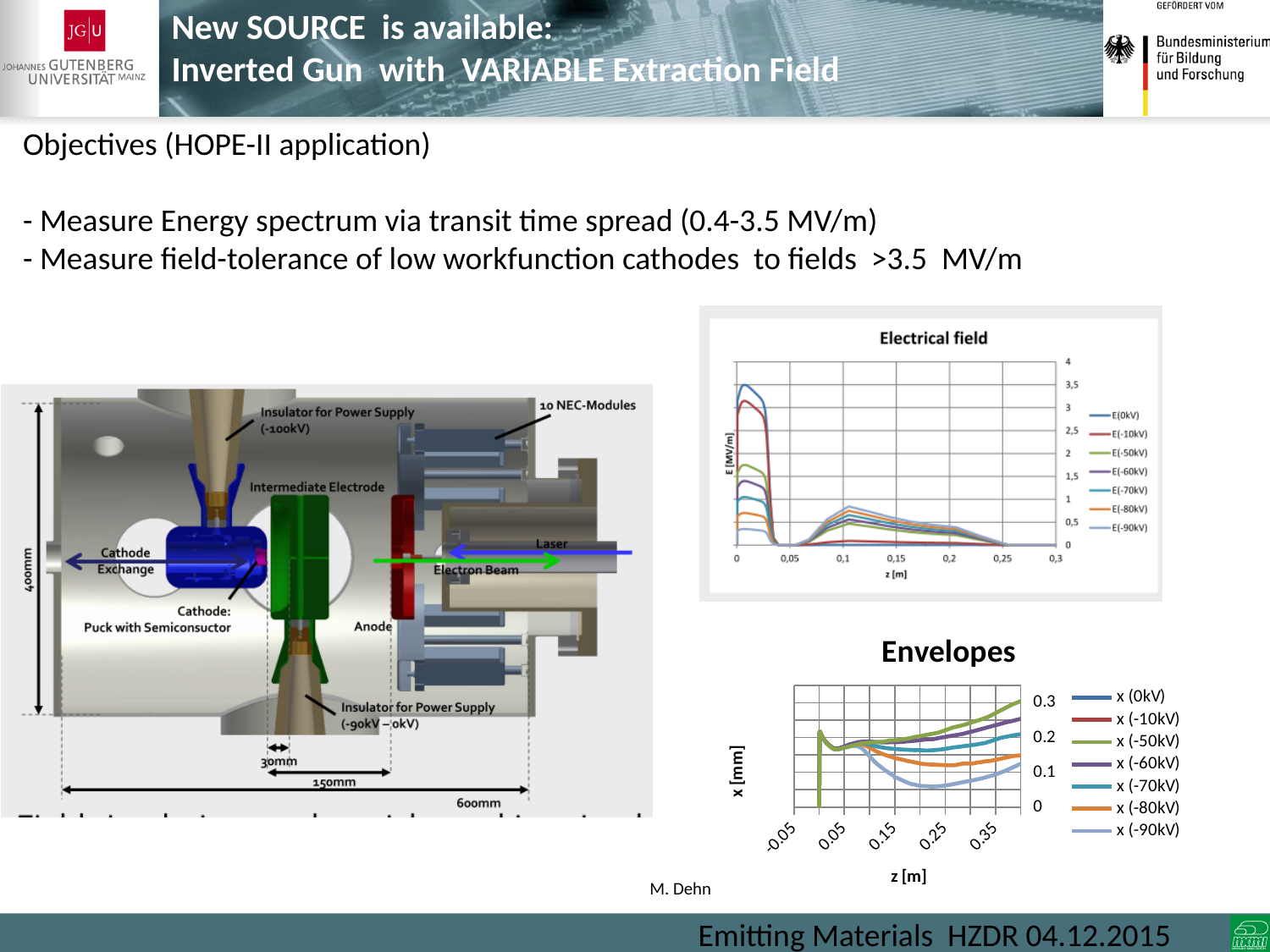
What kind of chart is the 'Electrical field' chart? line chart How many series does the legend of the 'Envelopes' chart list? 7 In the 'Electrical field' chart, which series has the lowest peak value? E(-90kV) In the 'Electrical field' chart, is the peak value of E(-90kV) greater or less than 1? less In the 'Electrical field' chart, is the peak value of E(0kV) greater or less than 3? greater What is the y-axis label of the 'Electrical field' chart? E [MV/m] In the 'Envelopes' chart, is the minimum value of x (-90kV) greater or less than 0.1? less How many series does the legend of the 'Electrical field' chart list? 7 What kind of chart is the 'Envelopes' chart? line chart What is the x-axis label of the 'Envelopes' chart? z [m] In the 'Electrical field' chart, which series reaches the highest peak value? E(0kV)